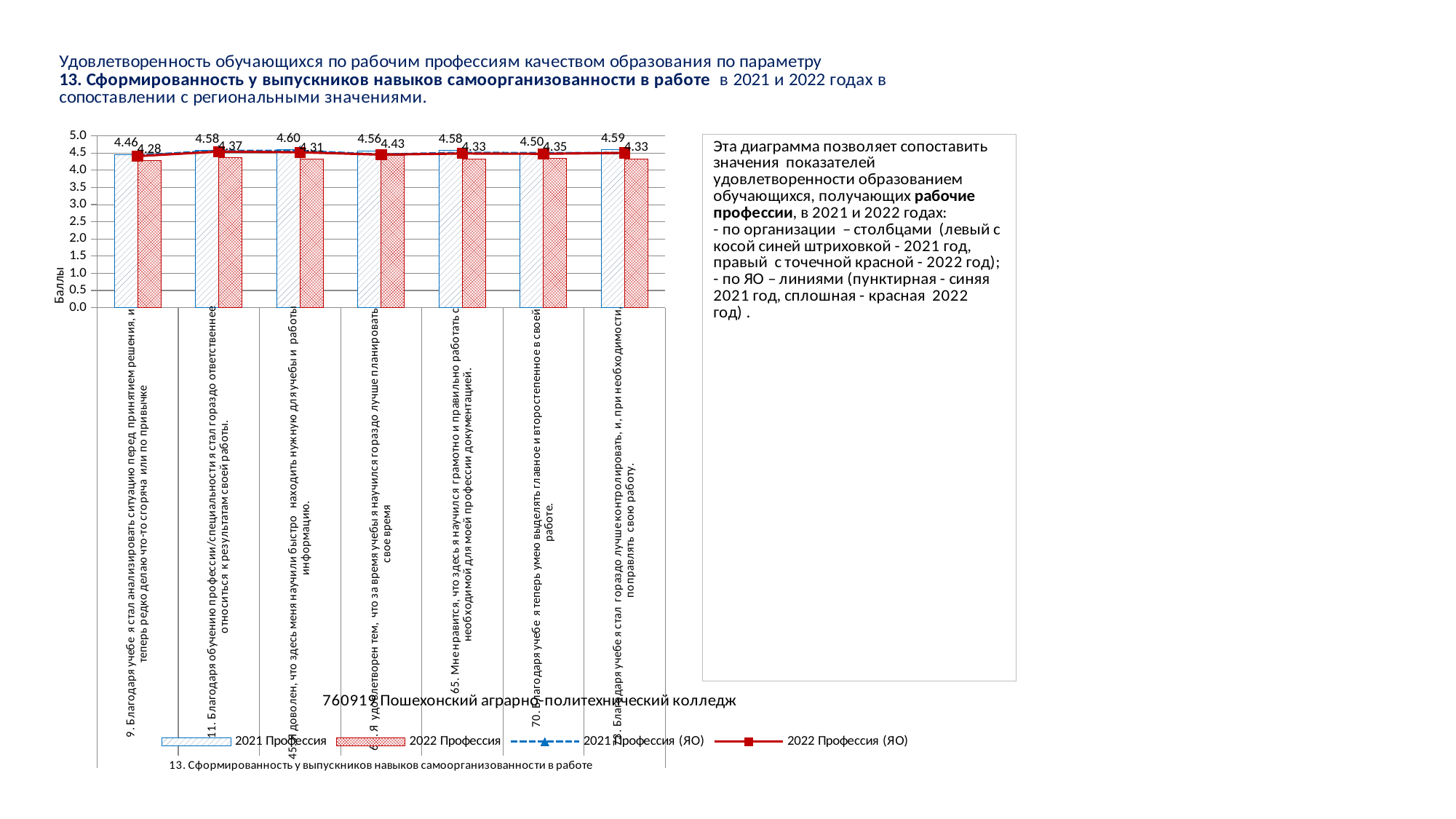
Is the value of the 2022 Профессия bar for statement 65 greater or less than 4.0? greater Which legend entry is drawn as a solid red line with square markers? 2022 Профессия (ЯО) What kind of chart is shown on the slide? Combined bar and line chart Which category has the lowest lower data label in the chart? 9. Благодаря учебе я стал анализировать ситуацию перед принятием решения (4.28) What is the difference between the two data labels shown for the first category (4.46 and 4.28)? 0.18 How many series does the chart legend list? 4 How many categories (statements) are plotted along the x axis of the chart? 7 What is the lower data label shown for the category of statement 70? 4.35 Which category has the highest upper data label in the chart? 45. Я доволен, что здесь меня научили быстро находить нужную для учебы и работы информацию (4.60) What is the lower data label shown for the first category (statement 9)? 4.28 What is the higher data label shown for the first category (statement 9)? 4.46 What is the higher data label shown for the category of statement 45? 4.60